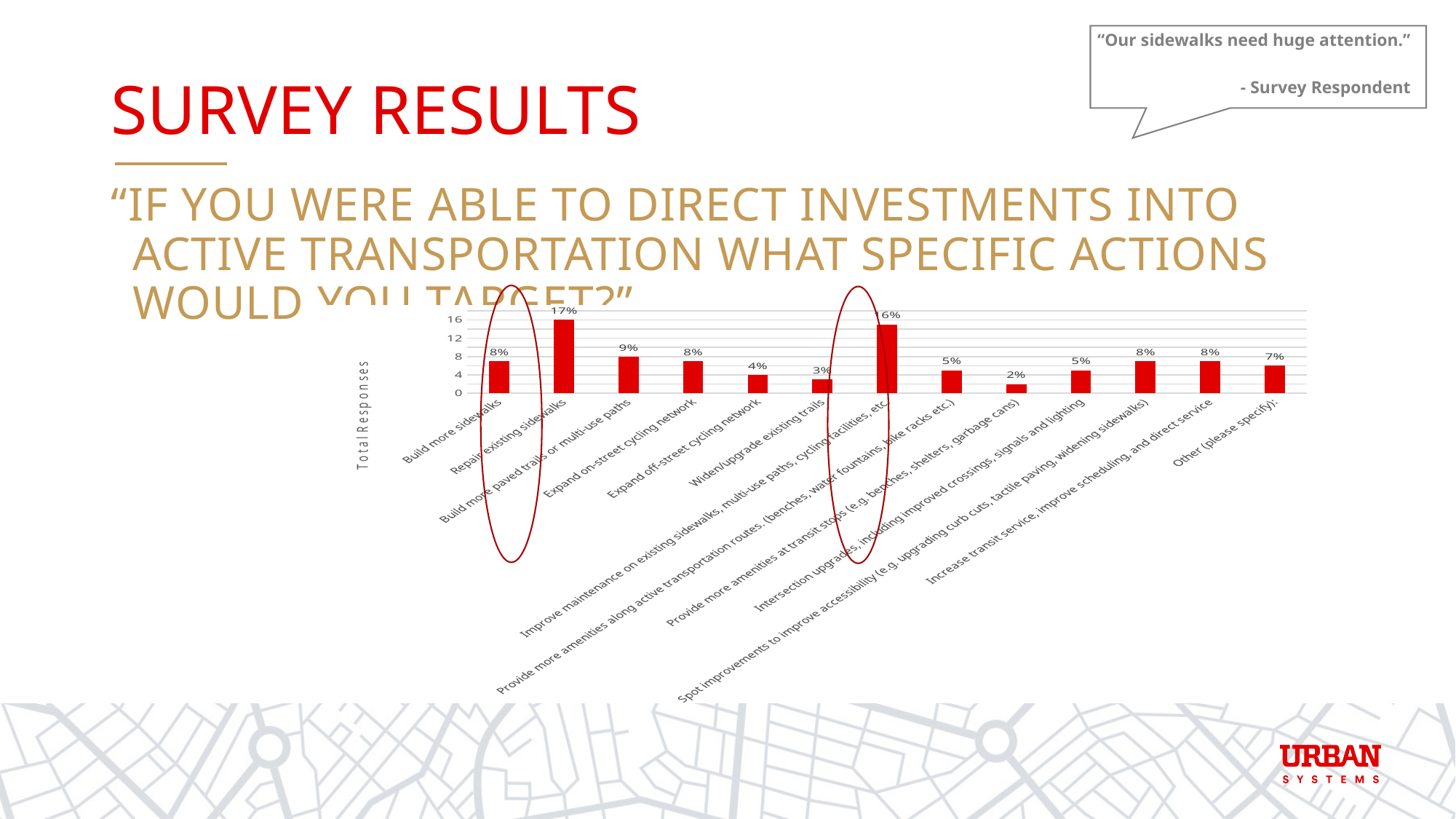
What percentage is shown for "Expand off-street cycling network"? 4% What is the label on the vertical axis of the chart? Total Responses Which category has the highest value in the chart? Repair existing sidewalks What is the difference between the values for "Repair existing sidewalks" and "Build more sidewalks"? 9% Is the value for "Improve maintenance on existing sidewalks, multi-use paths, cycling facilities, etc." greater or less than 12? greater What percentage is shown for "Repair existing sidewalks"? 17% How many categories are shown on the x axis of the chart? 13 Which category has the lowest value in the chart? Provide more amenities at transit stops (e.g. benches, shelters, garbage cans) What percentage is shown for "Other (please specify)"? 7% What kind of chart is shown on the slide? Bar chart What percentage is shown for "Widen/upgrade existing trails"? 3% Which is larger, the value for "Build more paved trails or multi-use paths" or the value for "Expand on-street cycling network"? Build more paved trails or multi-use paths